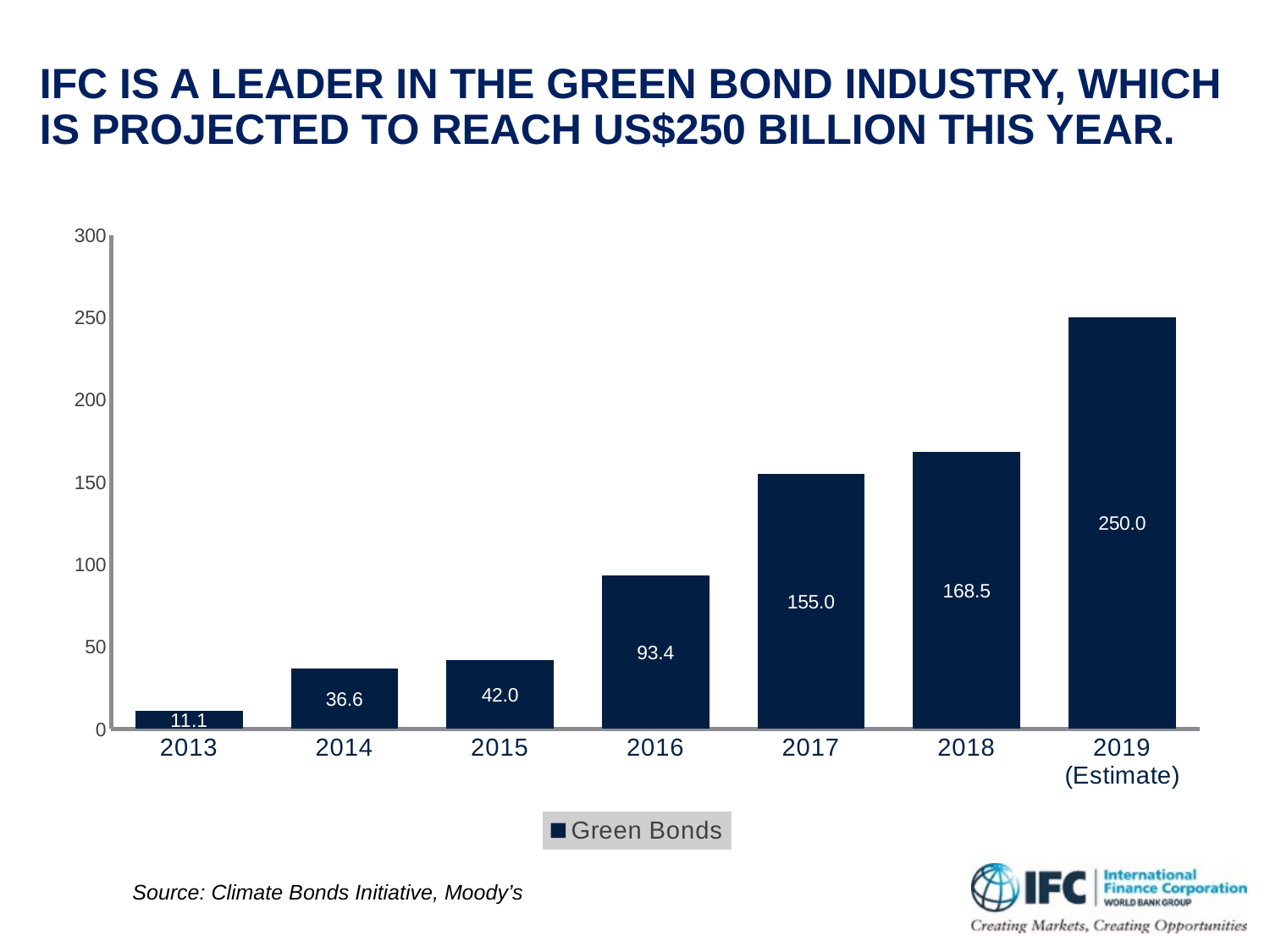
What kind of chart is shown on the slide? Bar chart What is the value for Green Bonds in 2018? 168.5 What is the difference between the Green Bonds values for 2018 and 2017? 13.5 Which year has the lowest Green Bonds value? 2013 Do the Green Bonds values rise or fall from 2013 to 2019? Rise Is the value for 2017 greater or less than 150? greater What is the difference between the Green Bonds values for 2016 and 2015? 51.4 What is the value for Green Bonds in 2013? 11.1 How many years are shown on the x axis? 7 Which year has the highest Green Bonds value? 2019 (Estimate) What is the value for Green Bonds in 2016? 93.4 Which is larger, the Green Bonds value for 2014 or for 2015? 2015